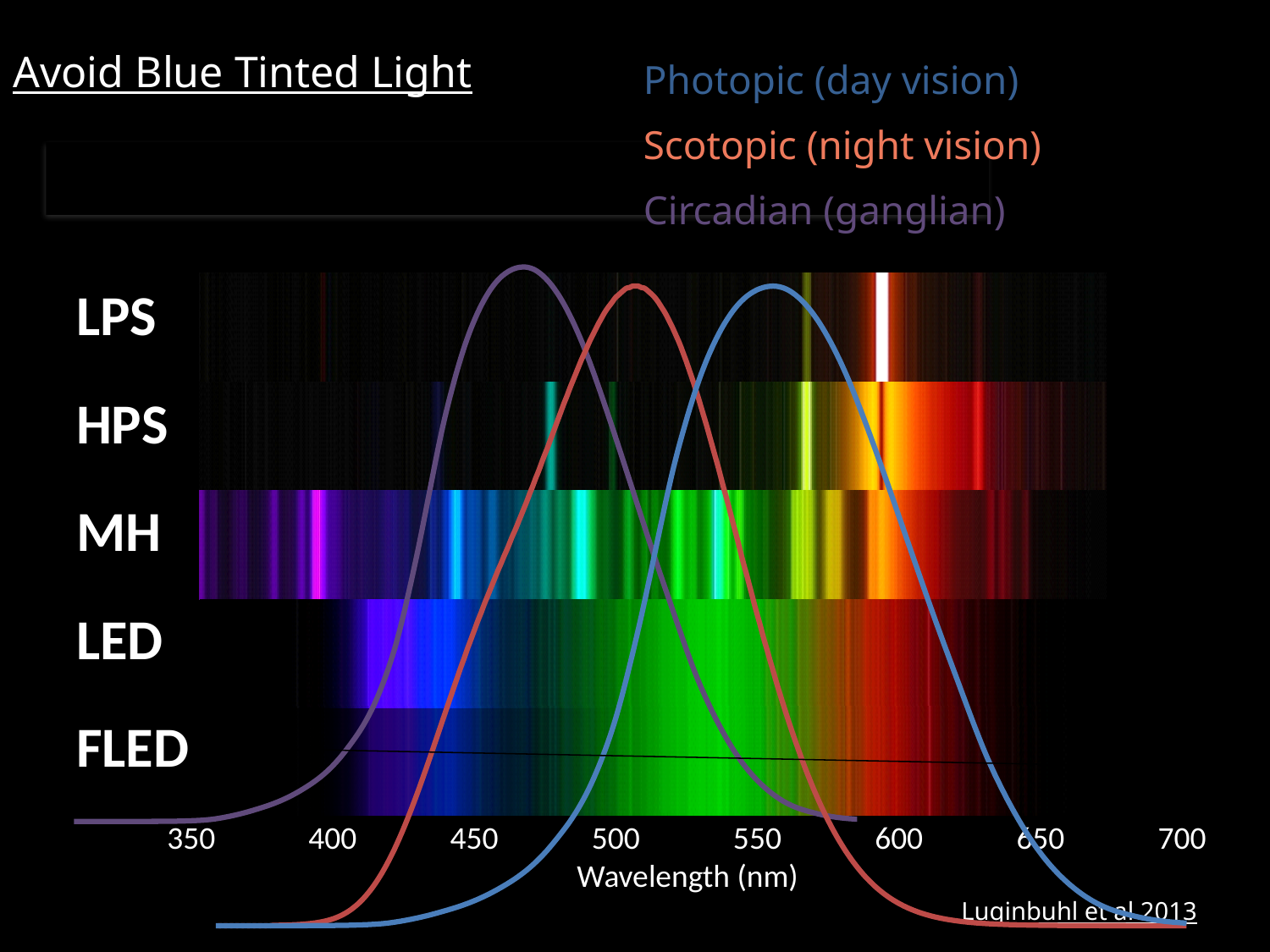
Which curve peaks at the shortest wavelength? Circadian (ganglian) What is the highest wavelength tick shown on the x axis? 700 What kind of chart is shown on the slide? line chart How many curves (series) does the legend list? 3 What colour is the Scotopic (night vision) curve? red Which curve peaks at a longer wavelength, Photopic (day vision) or Scotopic (night vision)? Photopic (day vision) What is the label of the x axis? Wavelength (nm) What is the lowest wavelength tick shown on the x axis? 350 Is the peak wavelength of the Circadian (ganglian) curve greater or less than 500 nm? less How many light source spectra are labelled along the left side of the chart? 5 Is the peak wavelength of the Photopic (day vision) curve greater or less than 500 nm? greater Which curve peaks at the longest wavelength? Photopic (day vision)